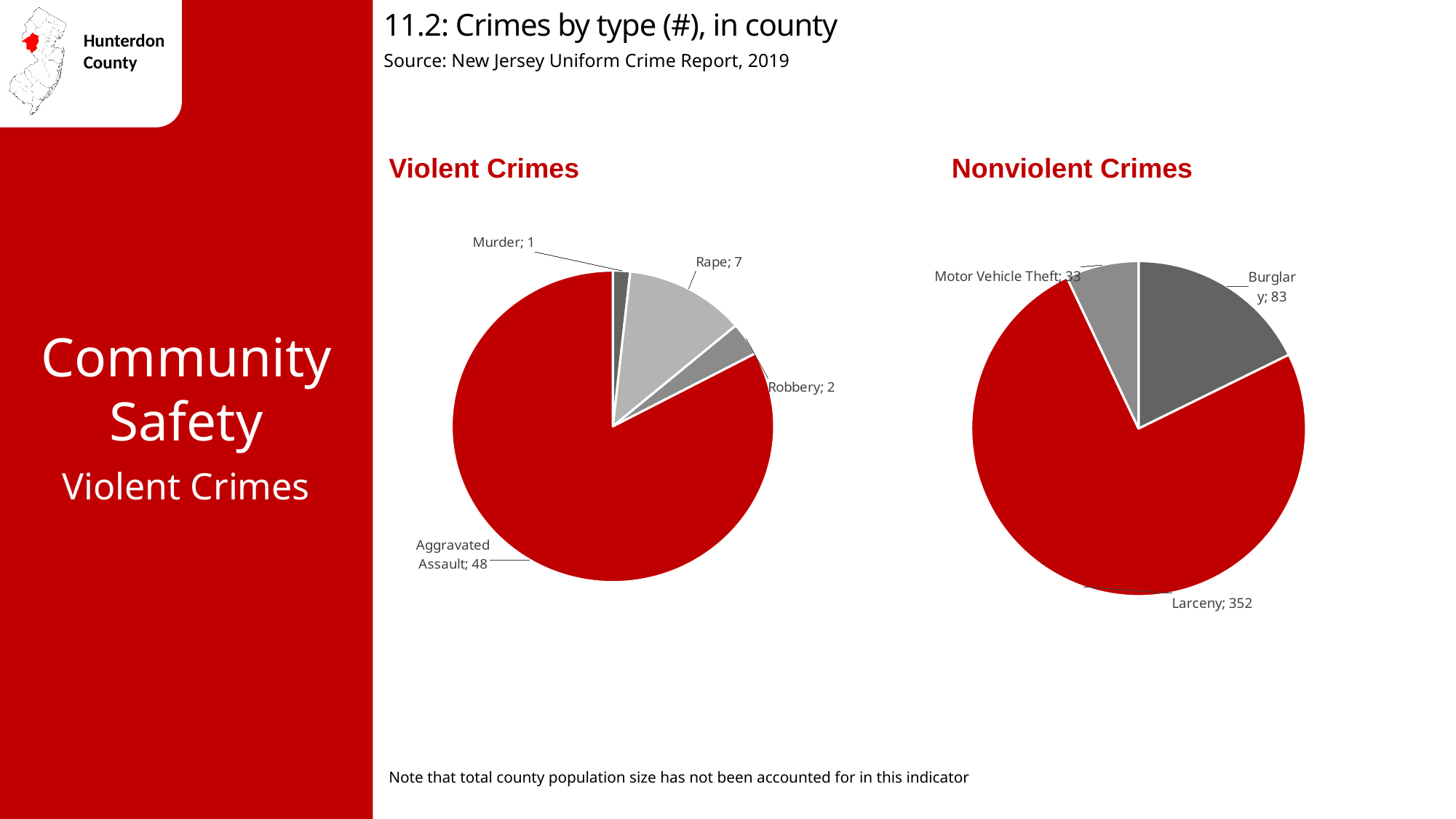
In the Violent Crimes pie chart, which crime type has the smallest value? Murder How many crime types are shown in the Violent Crimes pie chart? 4 In the Violent Crimes pie chart, how many aggravated assaults are shown? 48 What type of chart is used for Nonviolent Crimes? Pie chart In the Violent Crimes pie chart, which is larger, Rape or Robbery? Rape In the Nonviolent Crimes pie chart, what is the value for Burglary? 83 In the Nonviolent Crimes pie chart, what is the difference between Burglary and Motor Vehicle Theft? 50 In the Nonviolent Crimes pie chart, which crime type has the largest value? Larceny In the Violent Crimes pie chart, which crime type has the largest slice? Aggravated Assault In the Nonviolent Crimes pie chart, what is the value for Motor Vehicle Theft? 33 In the Violent Crimes pie chart, what is the value for Rape? 7 What is the source cited for the charts on this slide? New Jersey Uniform Crime Report, 2019